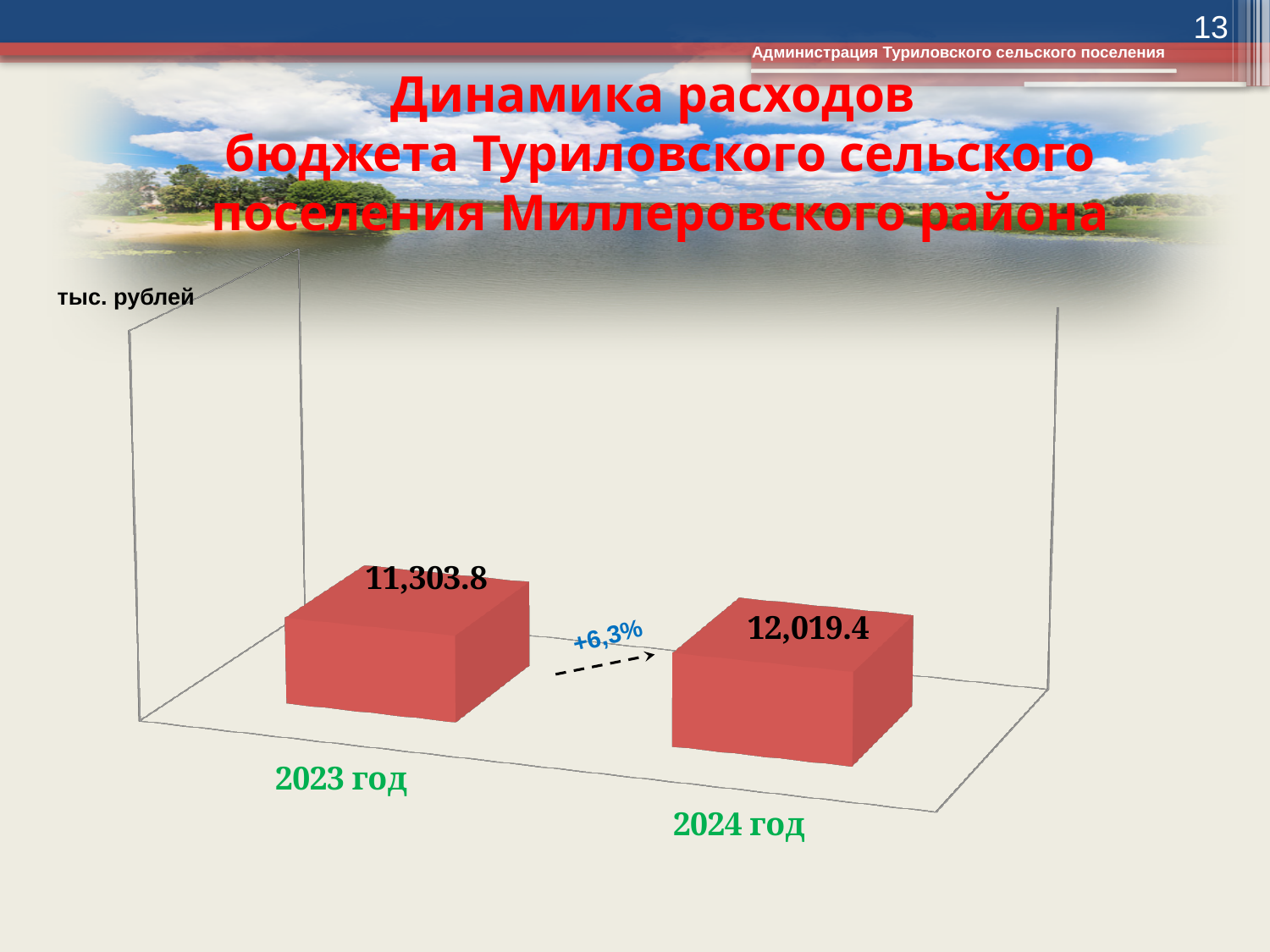
What is the difference between the values for 2024 год and 2023 год? 715.6 What unit of measurement is indicated on the chart? тыс. рублей Do the values rise or fall from 2023 год to 2024 год? rise What is the value for 2023 год? 11,303.8 What kind of chart is shown on the slide? bar chart How many categories are shown in the chart? 2 Which year has the lowest value? 2023 год Which is larger, the value for 2023 год or the value for 2024 год? 2024 год What is the total of the values for 2023 год and 2024 год? 23,323.2 What is the value for 2024 год? 12,019.4 What percentage change is shown by the arrow between the two bars? +6,3% Which year has the highest value? 2024 год